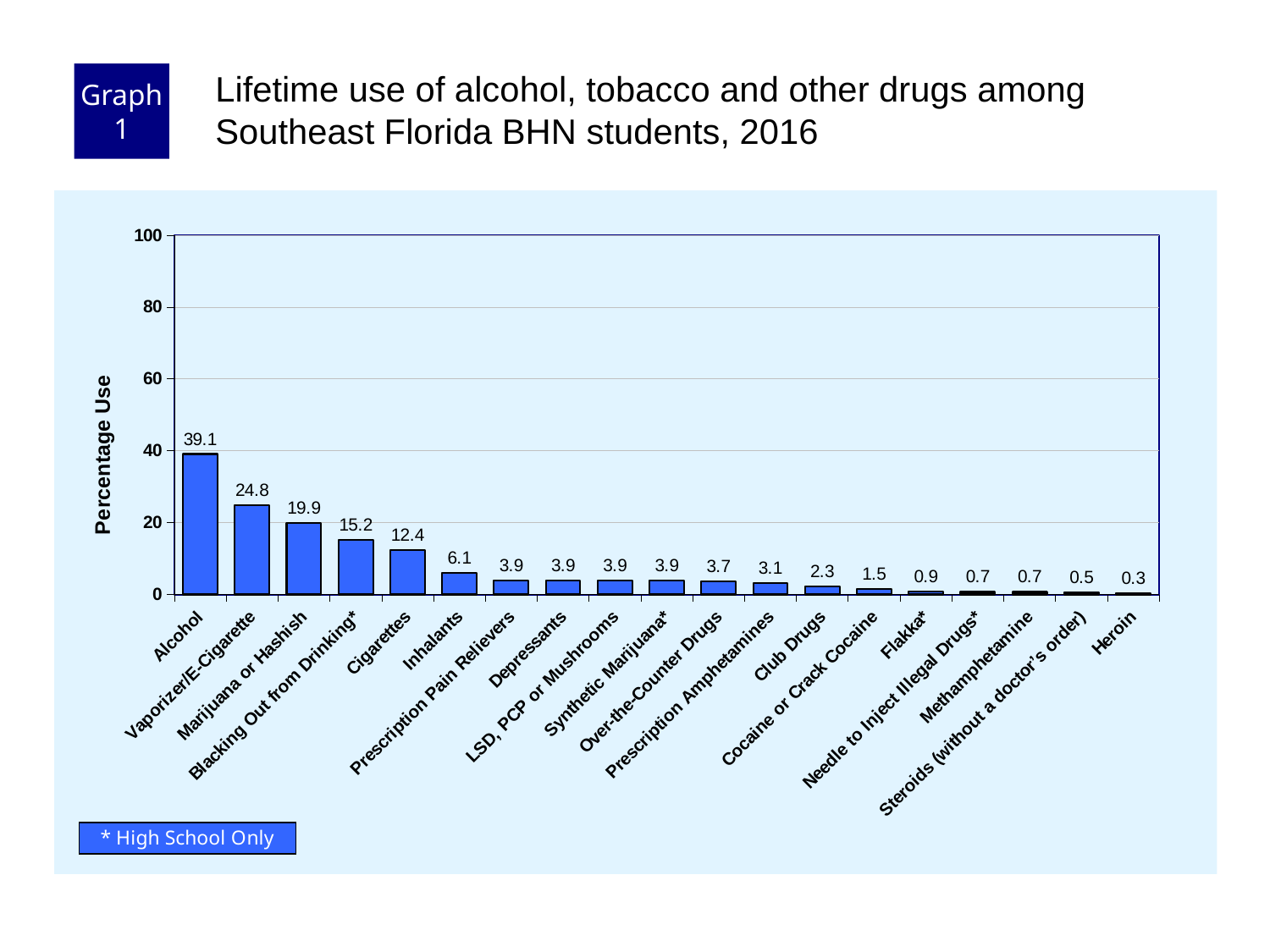
What is the percentage use for Heroin? 0.3 What is the percentage use for Cigarettes? 12.4 Which has a higher percentage use, Marijuana or Hashish or Cigarettes? Marijuana or Hashish Which category has the lowest percentage use? Heroin What is the difference in percentage use between Alcohol and Vaporizer/E-Cigarette? 14.3 What kind of chart is shown on the slide? Bar chart How many categories are shown on the x axis? 19 What is the percentage use for Alcohol? 39.1 What is the percentage use for Vaporizer/E-Cigarette? 24.8 What is the label of the y axis? Percentage Use Which category has the highest percentage use? Alcohol Is the value for Alcohol greater or less than 40? less